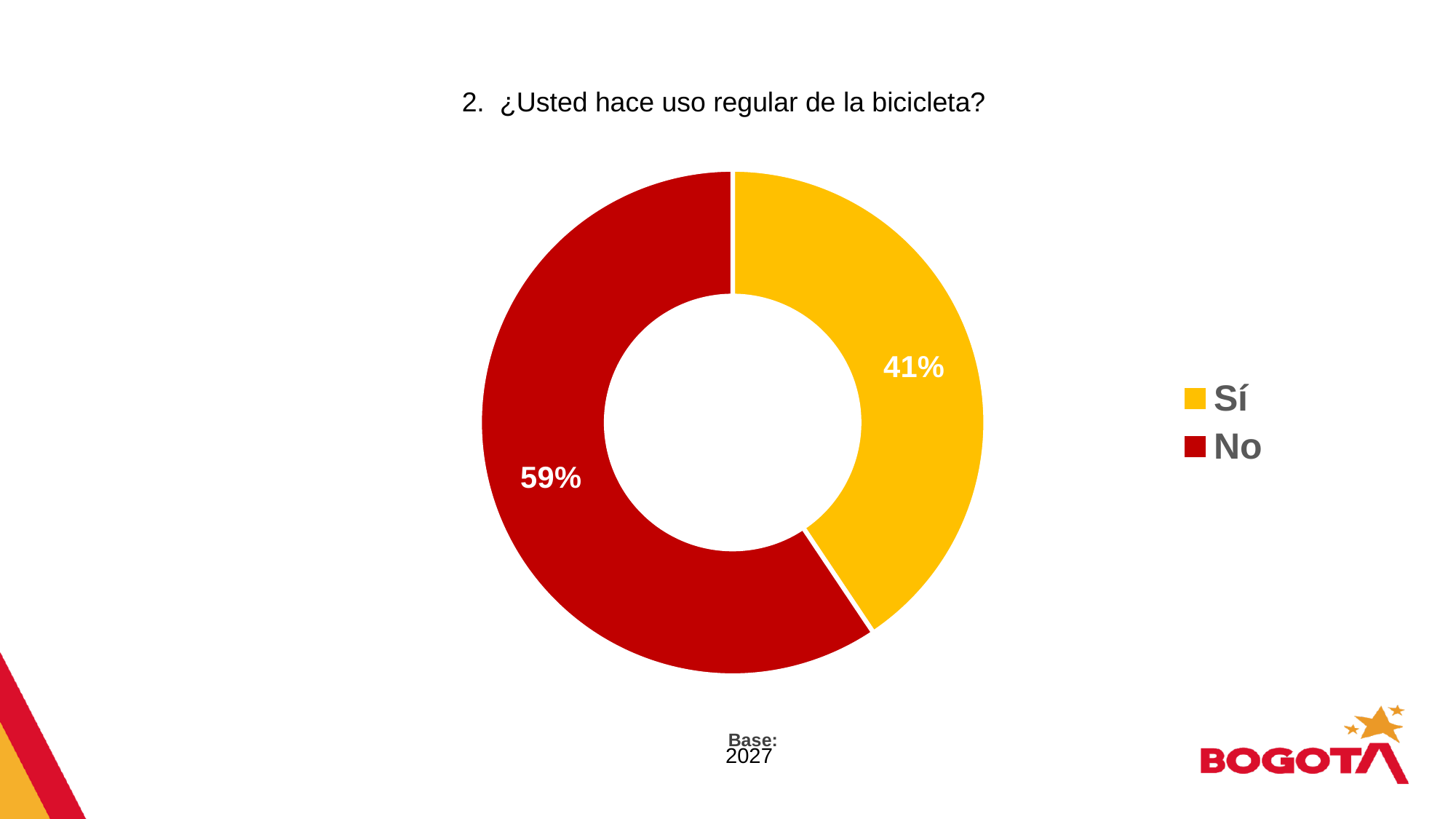
What is the share of the chart taken by the "No" slice? 59% Is the share for "Sí" larger or smaller than the share for "No"? smaller What percentage of respondents answered "No"? 59% Which response has the larger share of the chart? No What is the base (number of respondents) shown below the chart? 2027 How many entries does the legend list? 2 What kind of chart is shown on the slide? Pie chart (doughnut) What is the difference in percentage points between the "No" and "Sí" shares? 18 How many categories are shown in the chart? 2 Which response has the smaller share of the chart? Sí What colour represents "Sí" in the chart? Yellow What percentage of respondents answered "Sí"? 41%